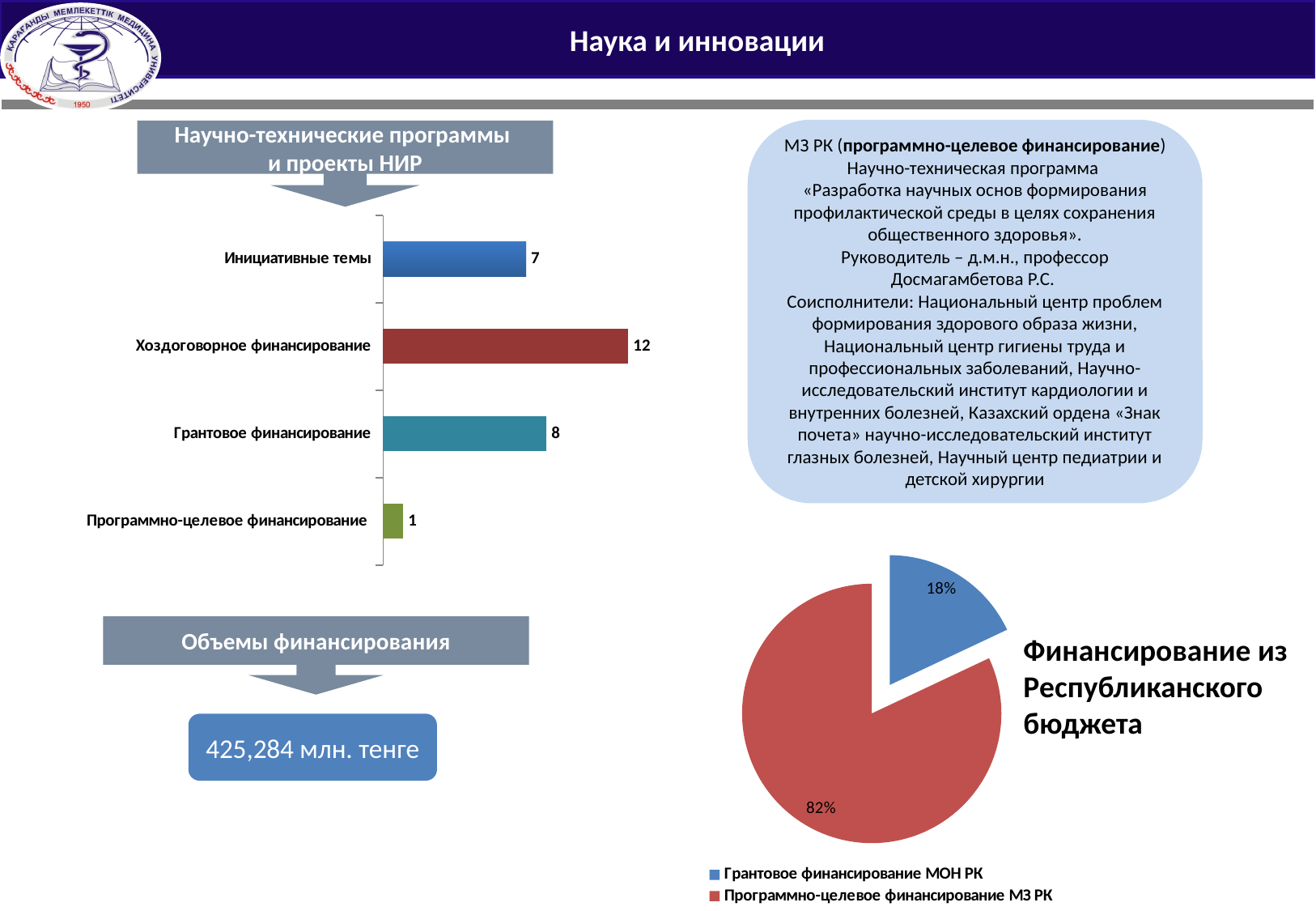
How many categories does the bar chart on the left show? 4 In the pie chart on the right, what share is Программно-целевое финансирование МЗ РК? 82% What kind of chart is shown on the left of the slide? Bar chart In the bar chart on the left, what is the value for Хоздоговорное финансирование? 12 In the pie chart on the right, what share is Грантовое финансирование МОН РК? 18% How many entries does the legend of the pie chart on the right list? 2 In the bar chart on the left, which category has the highest value? Хоздоговорное финансирование In the bar chart on the left, what is the value for Инициативные темы? 7 In the bar chart on the left, what is the difference between Хоздоговорное финансирование and Грантовое финансирование? 4 In the bar chart on the left, which category has the lowest value? Программно-целевое финансирование In the bar chart on the left, which is larger: Грантовое финансирование or Инициативные темы? Грантовое финансирование In the bar chart on the left, what is the value for Программно-целевое финансирование? 1